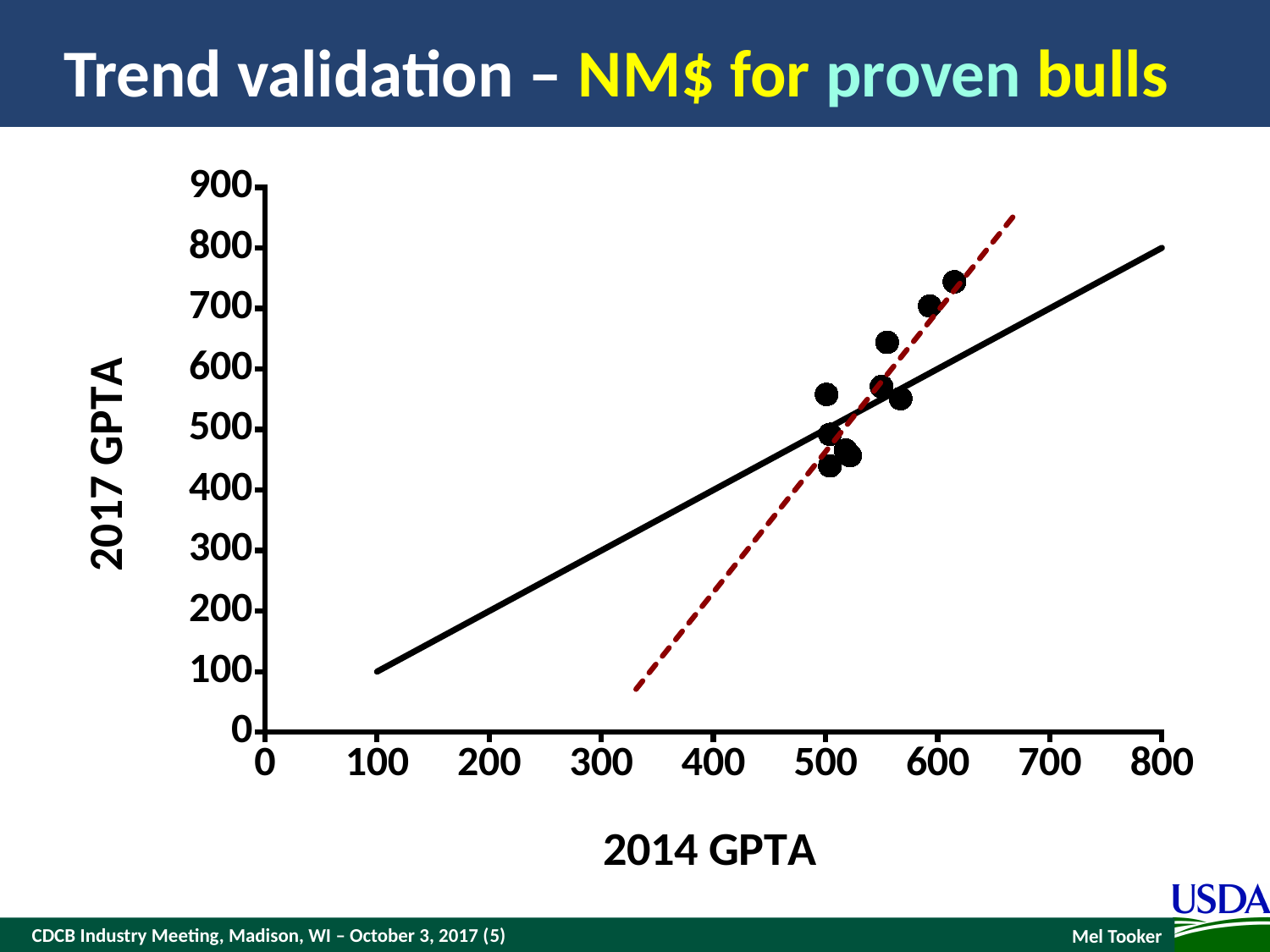
Is the 2017 GPTA of the lowest plotted point greater or less than 500? less What is the highest tick value shown on the x axis? 800 Is the 2014 GPTA of the rightmost plotted point greater or less than 700? less Is the 2017 GPTA of the highest plotted point greater or less than 700? greater What is the title of the y axis? 2017 GPTA At what 2017 GPTA value does the solid black line end at the right edge of the chart (x = 800)? 800 What is the spacing between consecutive tick labels on the y axis? 100 Do the plotted points generally rise or fall as the 2014 GPTA increases? rise What is the highest tick value shown on the y axis? 900 What is the title of the x axis? 2014 GPTA What kind of chart is shown on the slide? scatter chart